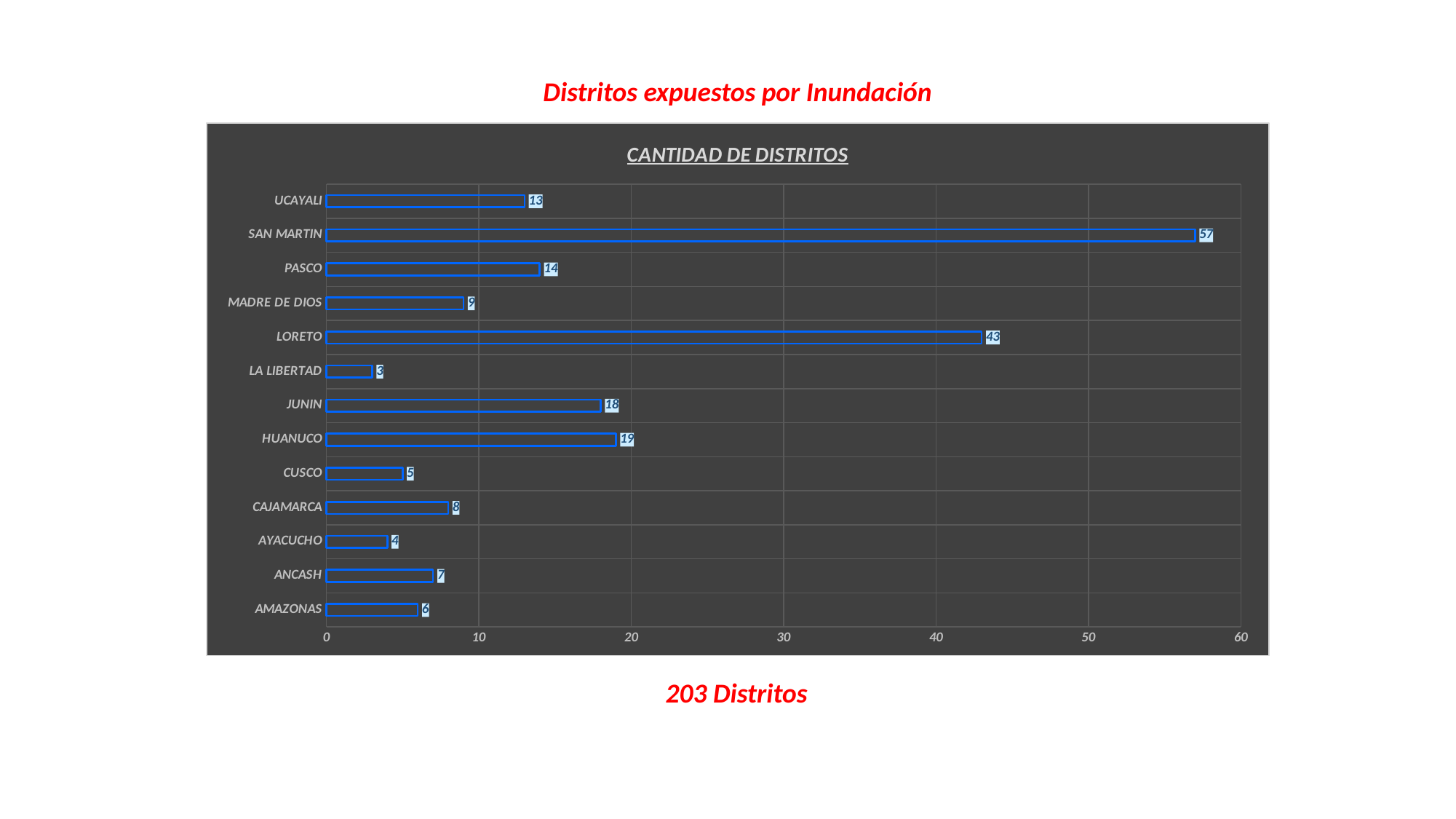
Which is larger, the value for JUNIN or the value for PASCO? JUNIN What is the title of the chart? CANTIDAD DE DISTRITOS How many categories are shown in the chart? 13 What is the value for SAN MARTIN? 57 What kind of chart is shown? bar chart What is the difference between the values for SAN MARTIN and LORETO? 14 What is the value for AMAZONAS? 6 What is the value for HUANUCO? 19 Is the value for UCAYALI greater or less than 10? greater Which category has the lowest value? LA LIBERTAD Which category has the highest value? SAN MARTIN What is the value for LORETO? 43